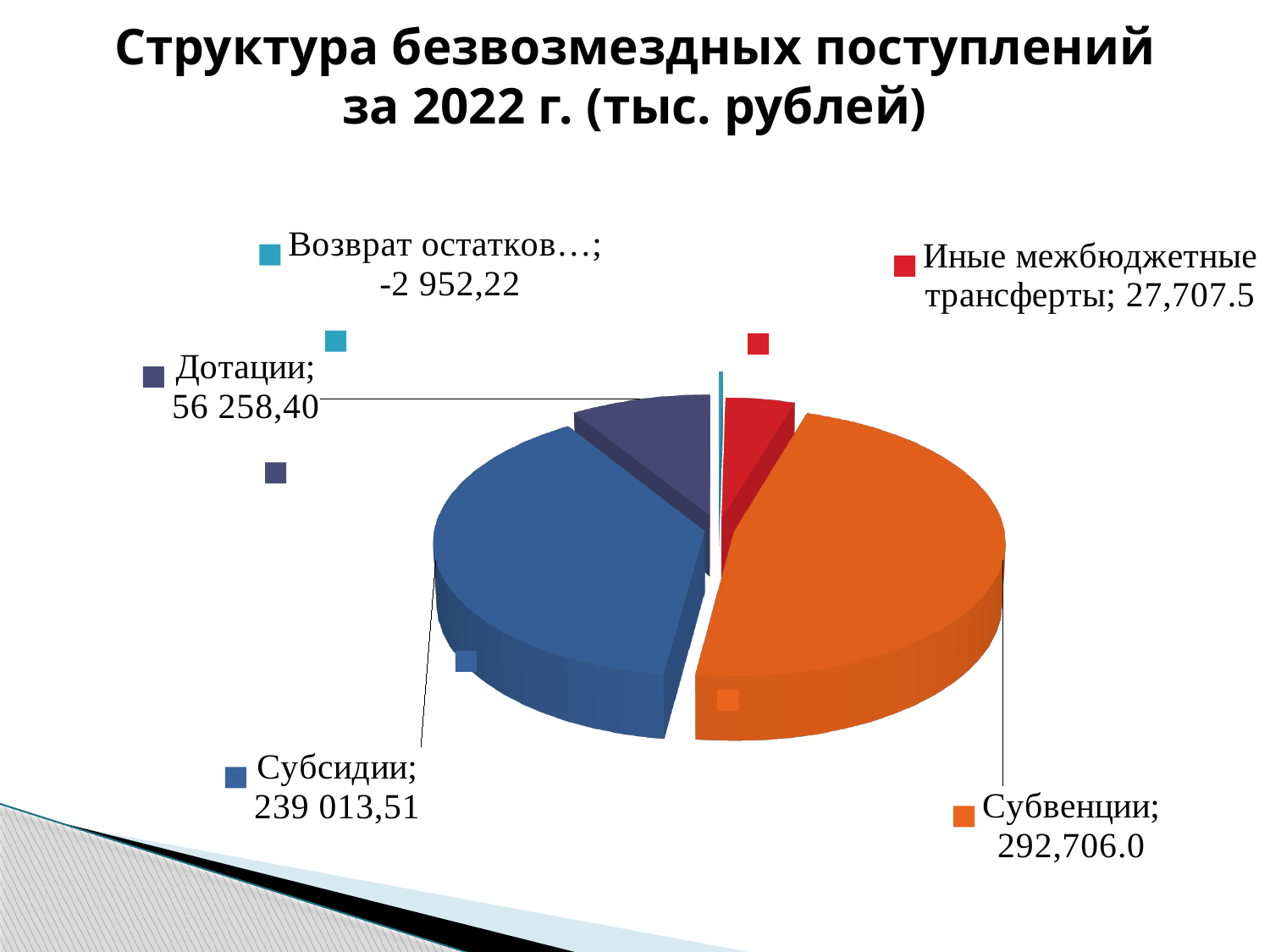
Which category has the lowest value? Возврат остатков… What is the title of the chart? Структура безвозмездных поступлений за 2022 г. (тыс. рублей) Which is larger, Иные межбюджетные трансферты or Дотации? Дотации What is the value for Субвенции? 292,706.0 Which category has the highest value? Субвенции What kind of chart is shown on the slide? Pie chart What is the value for Возврат остатков…? -2 952,22 What is the value for Иные межбюджетные трансферты? 27,707.5 What is the value for Дотации? 56 258,40 What is the value for Субсидии? 239 013,51 Which is larger, Субсидии or Дотации? Субсидии How many categories are shown in the pie chart? 5